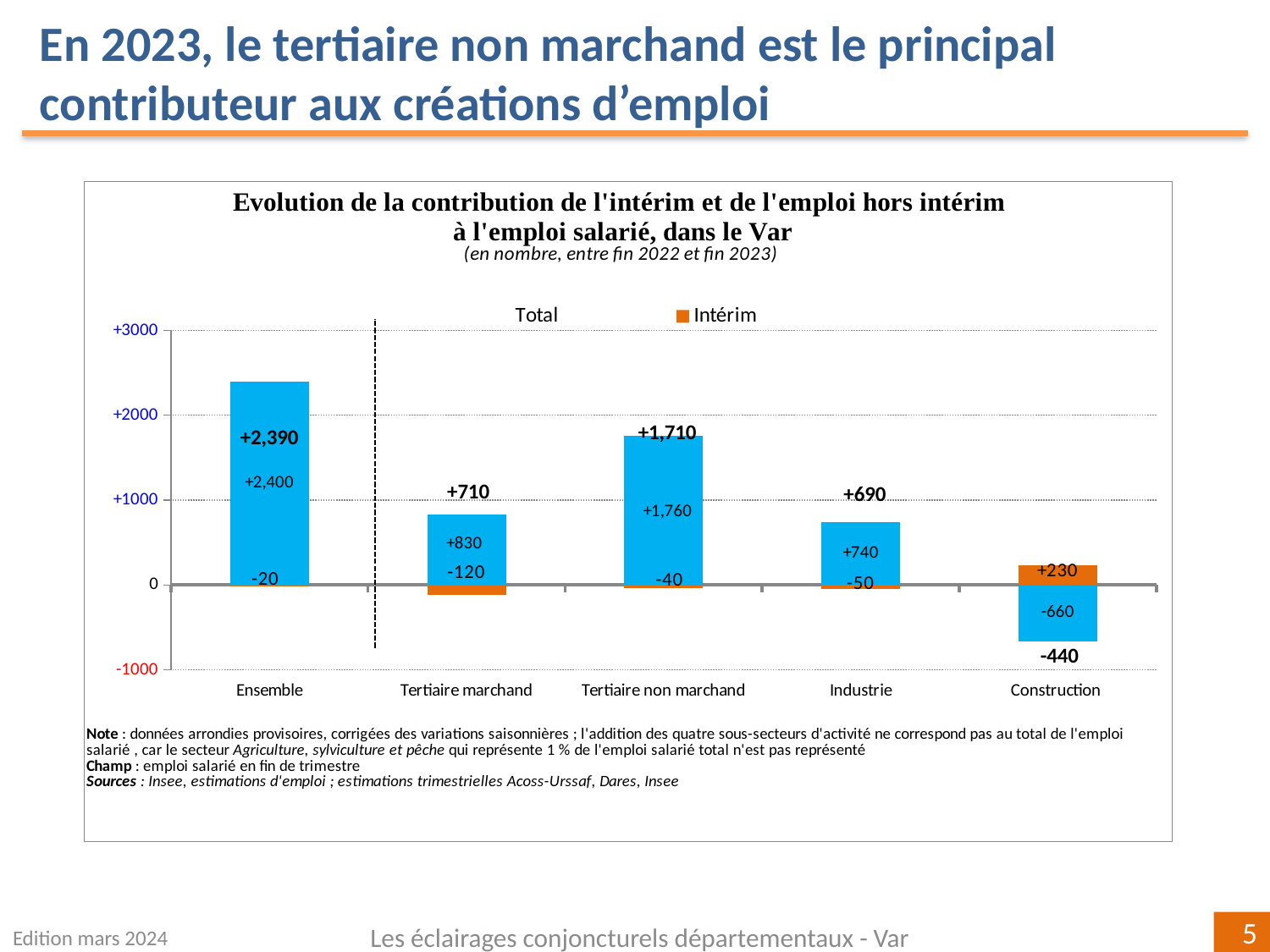
What is the total value shown for Ensemble? +2,390 How many categories are shown on the x axis? 5 Which category has the lowest total value? Construction What is the difference between the total for Tertiaire non marchand and the total for Industrie? 1,020 What is the Intérim value for Tertiaire marchand? -120 Which has the larger total value, Tertiaire marchand or Industrie? Tertiaire marchand What is the value of the blue segment for Industrie? +740 What kind of chart is shown on the slide? Bar chart Among the four sectors (excluding Ensemble), which has the highest total value? Tertiaire non marchand Is the total value for Ensemble greater or less than +2000? greater What is the total value shown for Tertiaire non marchand? +1,710 What is the Intérim value for Construction? +230